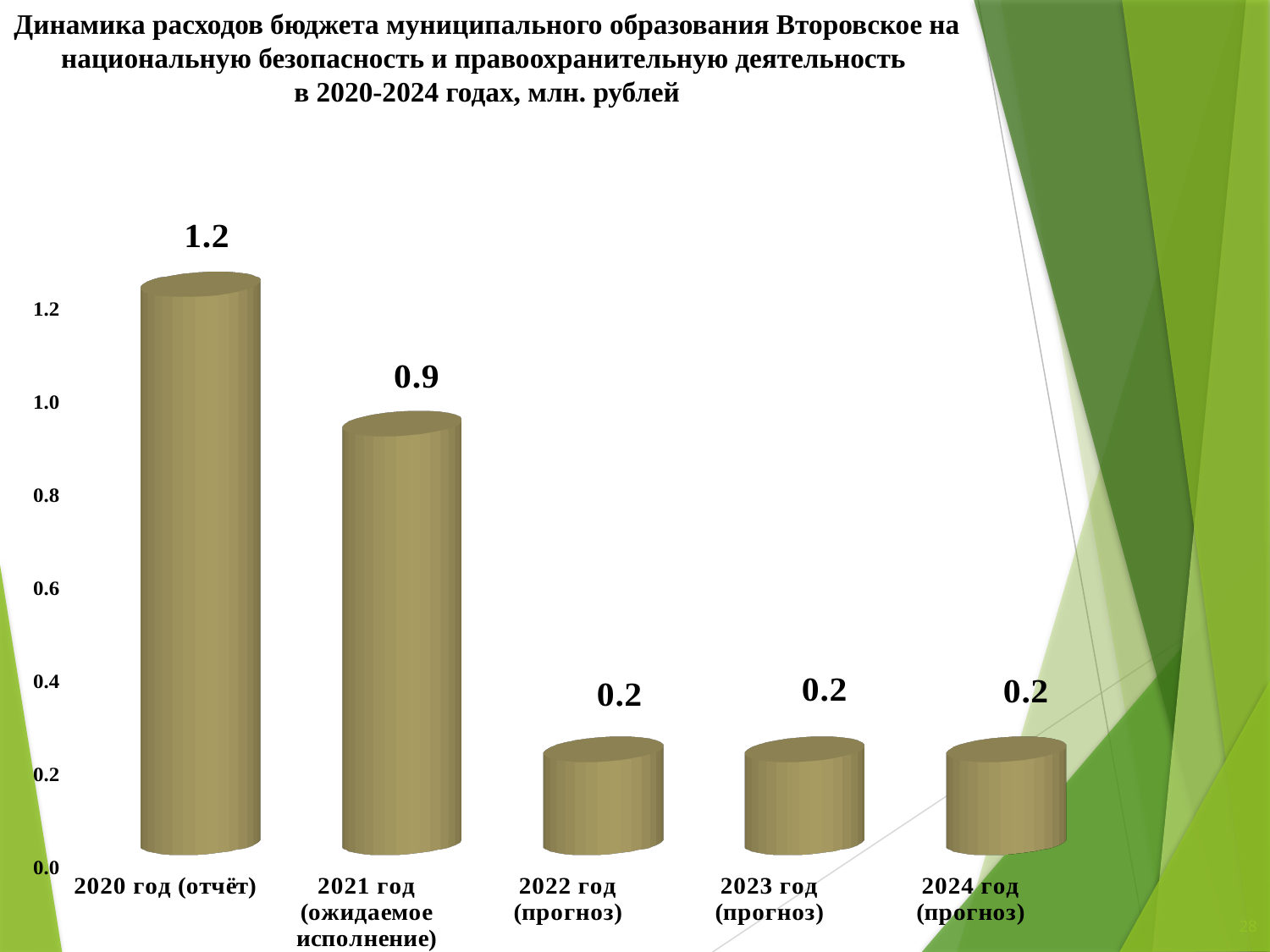
Is the value for 2021 год (ожидаемое исполнение) greater or less than 1.0? less In what units are the values on the chart expressed, according to the title? млн. рублей Do the values rise or fall from 2020 to 2022? fall How many categories are shown on the chart? 5 What kind of chart is shown on the slide? bar chart What is the value for 2023 год (прогноз)? 0.2 What is the difference between the values for 2020 год (отчёт) and 2021 год (ожидаемое исполнение)? 0.3 What is the value for 2020 год (отчёт)? 1.2 Which year has the highest value? 2020 год (отчёт) What is the difference between the values for 2021 год (ожидаемое исполнение) and 2022 год (прогноз)? 0.7 Which is larger, the value for 2021 год (ожидаемое исполнение) or the value for 2024 год (прогноз)? 2021 год (ожидаемое исполнение) What is the value for 2021 год (ожидаемое исполнение)? 0.9